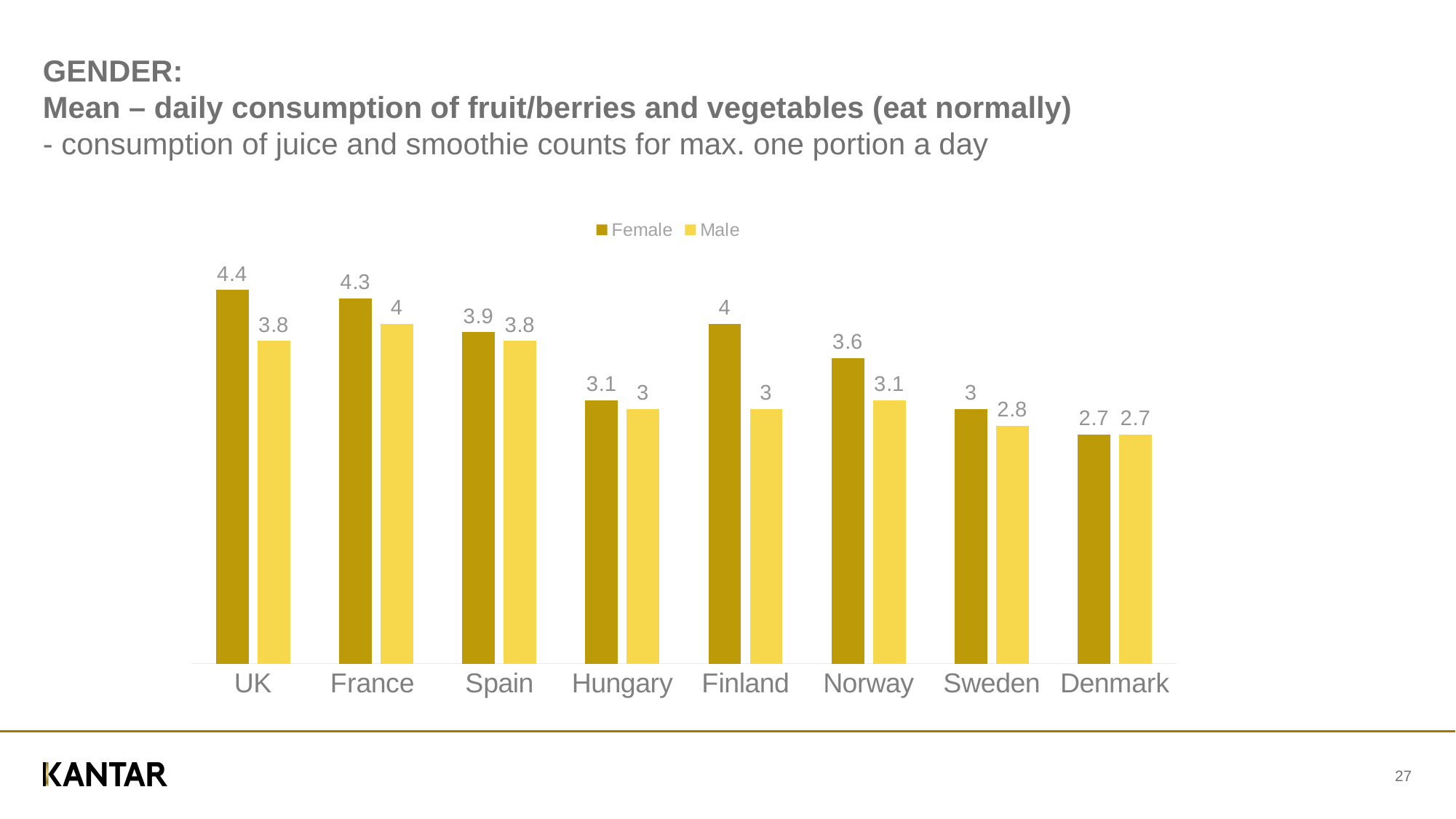
What is the Female value for Norway? 3.6 What is the Female value for the UK? 4.4 What is the Male value for France? 4 What is the difference between the Female and Male values for Finland? 1 Which country has the lowest Male value? Denmark Which series is shown in the darker gold colour? Female What is the Male value for Sweden? 2.8 Which is larger for Spain, the Female value or the Male value? Female What kind of chart is shown on the slide? Bar chart How many countries are shown on the x axis? 8 How many series does the legend list? 2 Which country has the highest Female value? UK